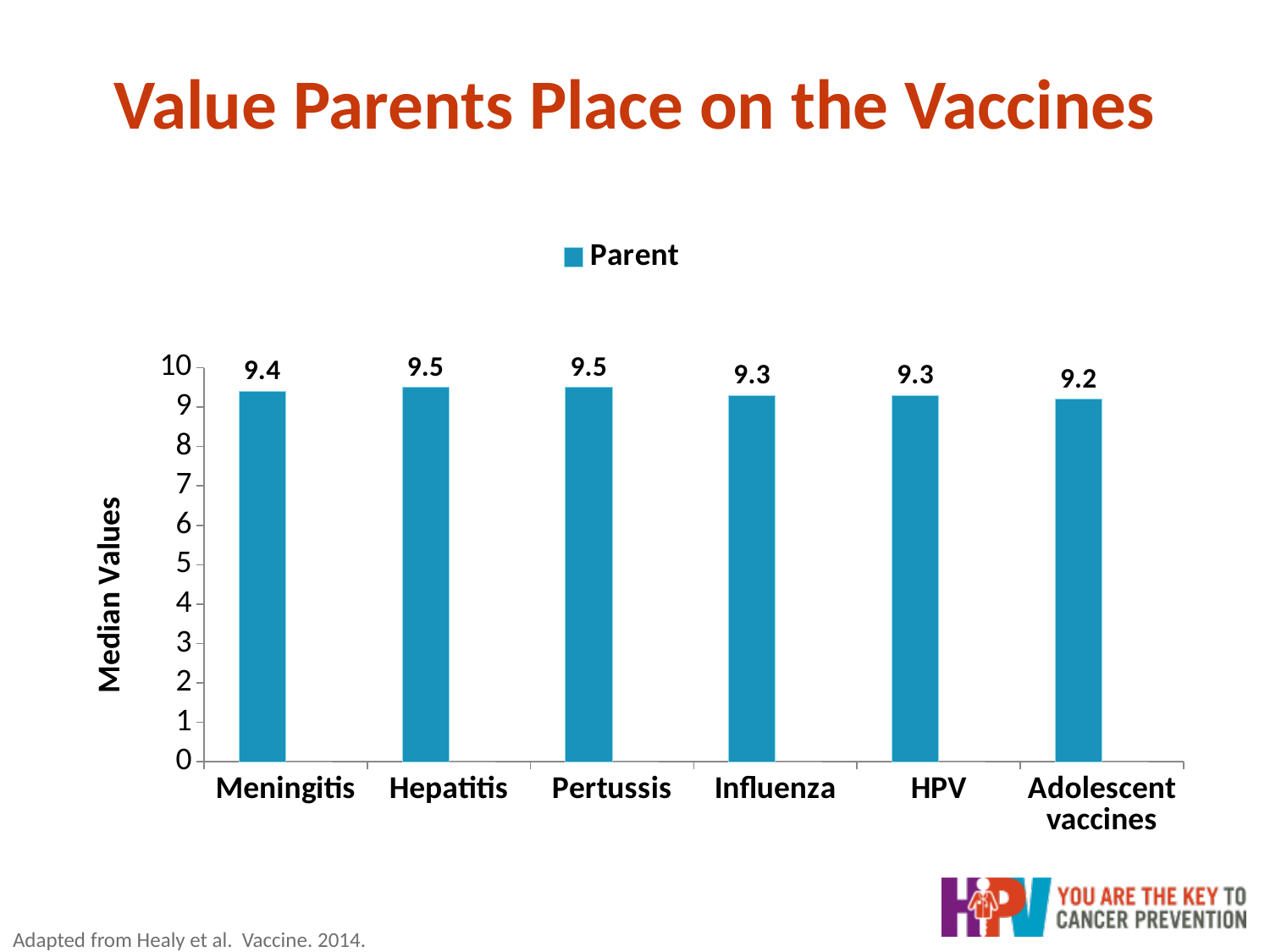
What is the median value for Influenza? 9.3 How many series does the legend list? 1 What is the median value for HPV? 9.3 What is the difference between the median values for Meningitis and HPV? 0.1 What is the label of the y axis? Median Values What is the median value for Meningitis? 9.4 Which has a larger median value, Pertussis or Influenza? Pertussis What kind of chart is shown on the slide? Bar chart What is the difference between the median values for Hepatitis and Adolescent vaccines? 0.3 How many categories are shown on the x axis? 6 What is the median value for Adolescent vaccines? 9.2 Which category has the lowest median value? Adolescent vaccines